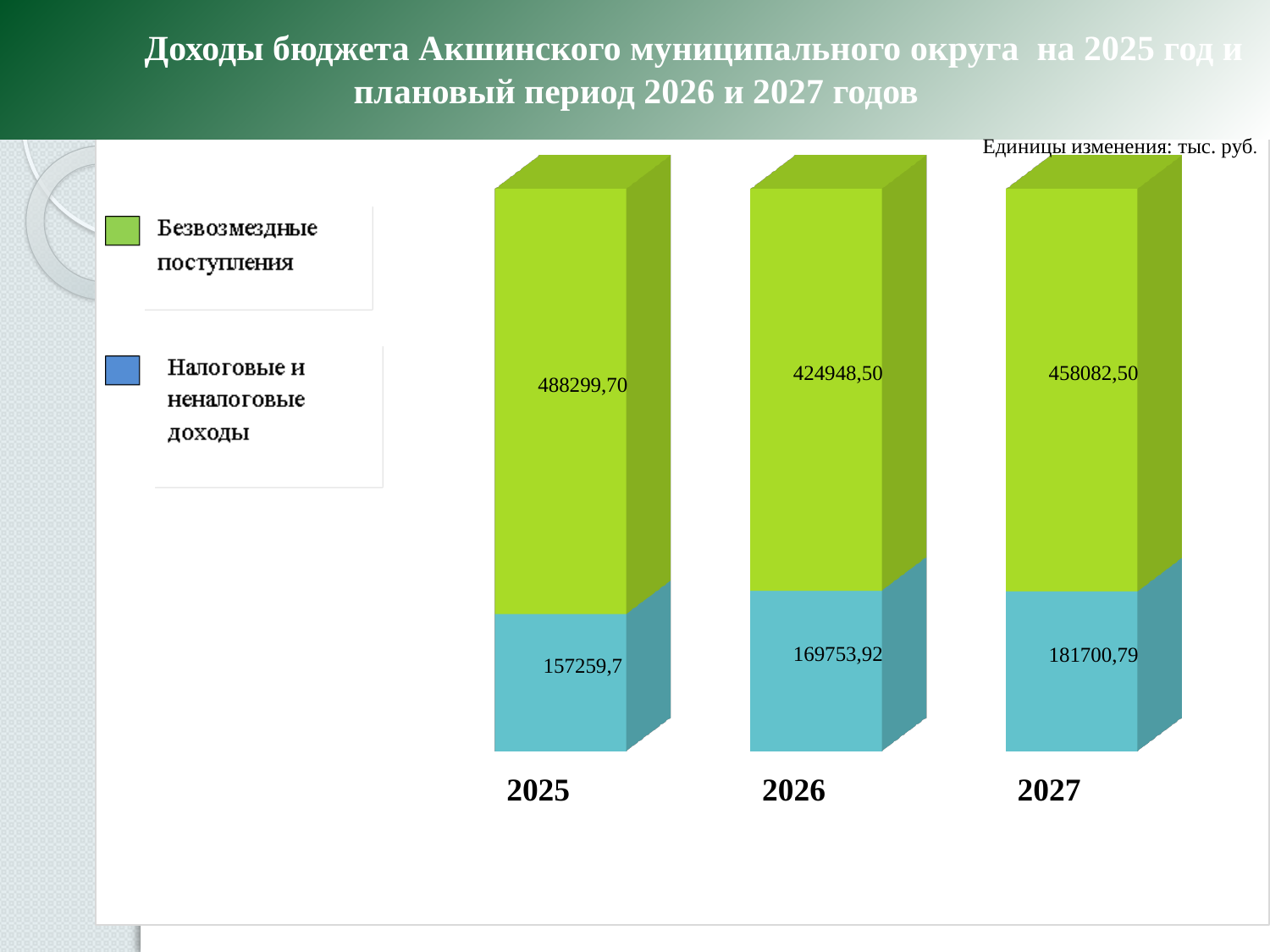
How many years are shown on the x axis? 3 What kind of chart is shown on the slide? Stacked bar chart What is the value of Налоговые и неналоговые доходы for 2026? 169753,92 What is the total of the stacked bar for 2025? 645559,40 What is the difference between Безвозмездные поступления in 2025 and in 2026? 63351,20 What unit of measurement is stated on the slide? тыс. руб. What is the value of Налоговые и неналоговые доходы for 2027? 181700,79 In which year is Налоговые и неналоговые доходы the lowest? 2025 What is the value of Безвозмездные поступления for 2025? 488299,70 In which year is Безвозмездные поступления the highest? 2025 How many series does the legend list? 2 Which is larger: Налоговые и неналоговые доходы in 2026 or in 2027? 2027